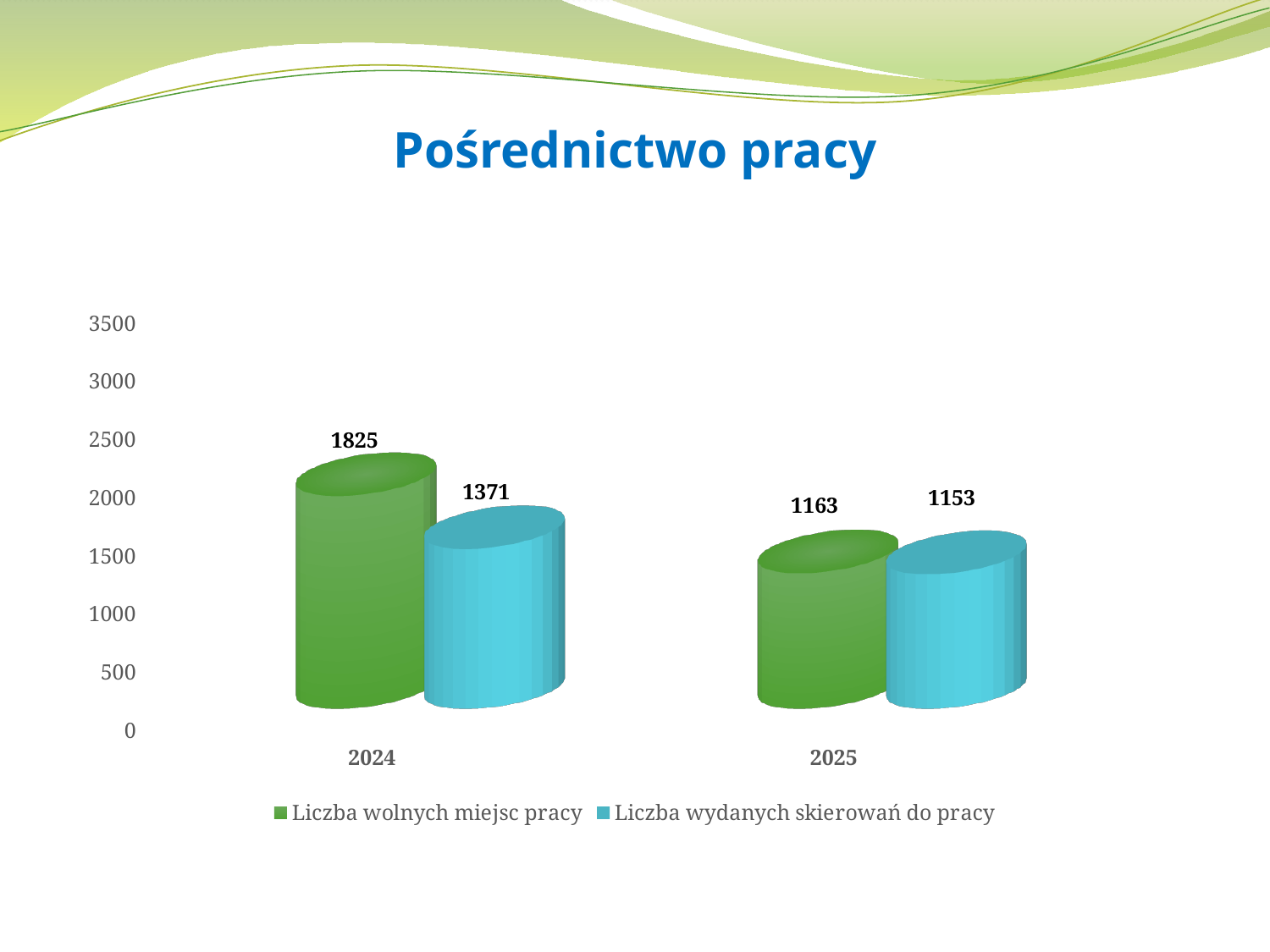
How many series does the legend list? 2 What is the value of 'Liczba wolnych miejsc pracy' for 2024? 1825 Which is larger in 2024: 'Liczba wolnych miejsc pracy' or 'Liczba wydanych skierowań do pracy'? Liczba wolnych miejsc pracy By how much did 'Liczba wolnych miejsc pracy' decrease from 2024 to 2025? 662 What kind of chart is shown on the slide? Bar chart Does 'Liczba wydanych skierowań do pracy' rise or fall from 2024 to 2025? Fall What is the value of 'Liczba wydanych skierowań do pracy' for 2024? 1371 What is the value of 'Liczba wydanych skierowań do pracy' for 2025? 1153 Which year has the lowest value for 'Liczba wydanych skierowań do pracy'? 2025 Which year has the highest value for 'Liczba wolnych miejsc pracy'? 2024 What is the difference between 'Liczba wolnych miejsc pracy' and 'Liczba wydanych skierowań do pracy' in 2024? 454 What is the value of 'Liczba wolnych miejsc pracy' for 2025? 1163